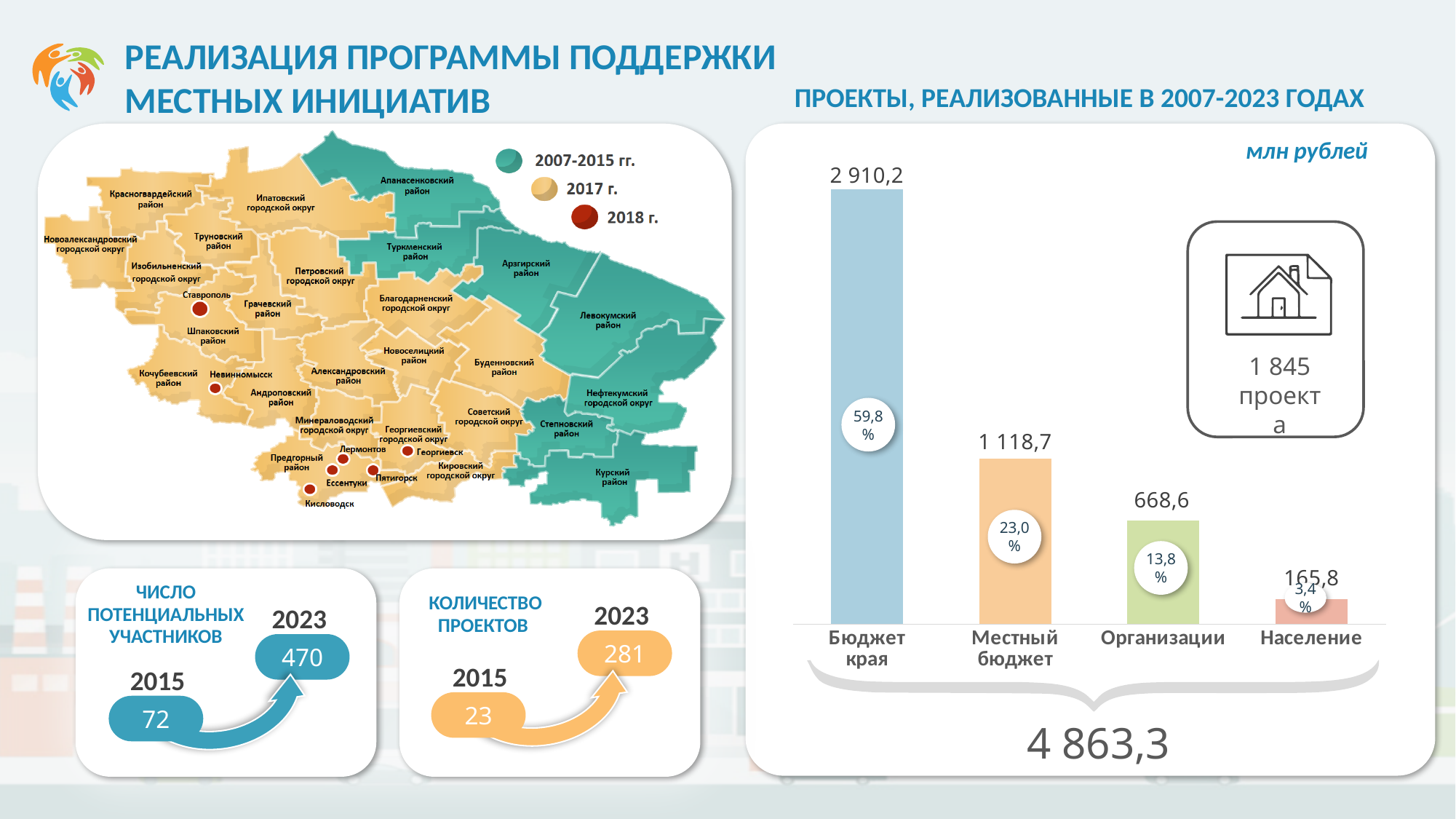
On the bar chart 'Проекты, реализованные в 2007-2023 годах', what is the value for Бюджет края? 2 910,2 On the bar chart 'Проекты, реализованные в 2007-2023 годах', what is the difference between the values for Бюджет края and Местный бюджет? 1 791,5 How many categories are shown on the bar chart 'Проекты, реализованные в 2007-2023 годах'? 4 What kind of chart is 'Проекты, реализованные в 2007-2023 годах'? Bar chart On the bar chart 'Проекты, реализованные в 2007-2023 годах', what is the value for Население? 165,8 On the bar chart 'Проекты, реализованные в 2007-2023 годах', what is the value for Местный бюджет? 1 118,7 On the bar chart 'Проекты, реализованные в 2007-2023 годах', what percentage share is shown for Местный бюджет? 23,0% On the bar chart 'Проекты, реализованные в 2007-2023 годах', what is the value for Организации? 668,6 On the bar chart 'Проекты, реализованные в 2007-2023 годах', which category has the lowest value? Население What unit of measurement is indicated on the bar chart 'Проекты, реализованные в 2007-2023 годах'? млн рублей On the bar chart 'Проекты, реализованные в 2007-2023 годах', which is larger: the value for Организации or the value for Население? Организации On the bar chart 'Проекты, реализованные в 2007-2023 годах', which category has the highest value? Бюджет края